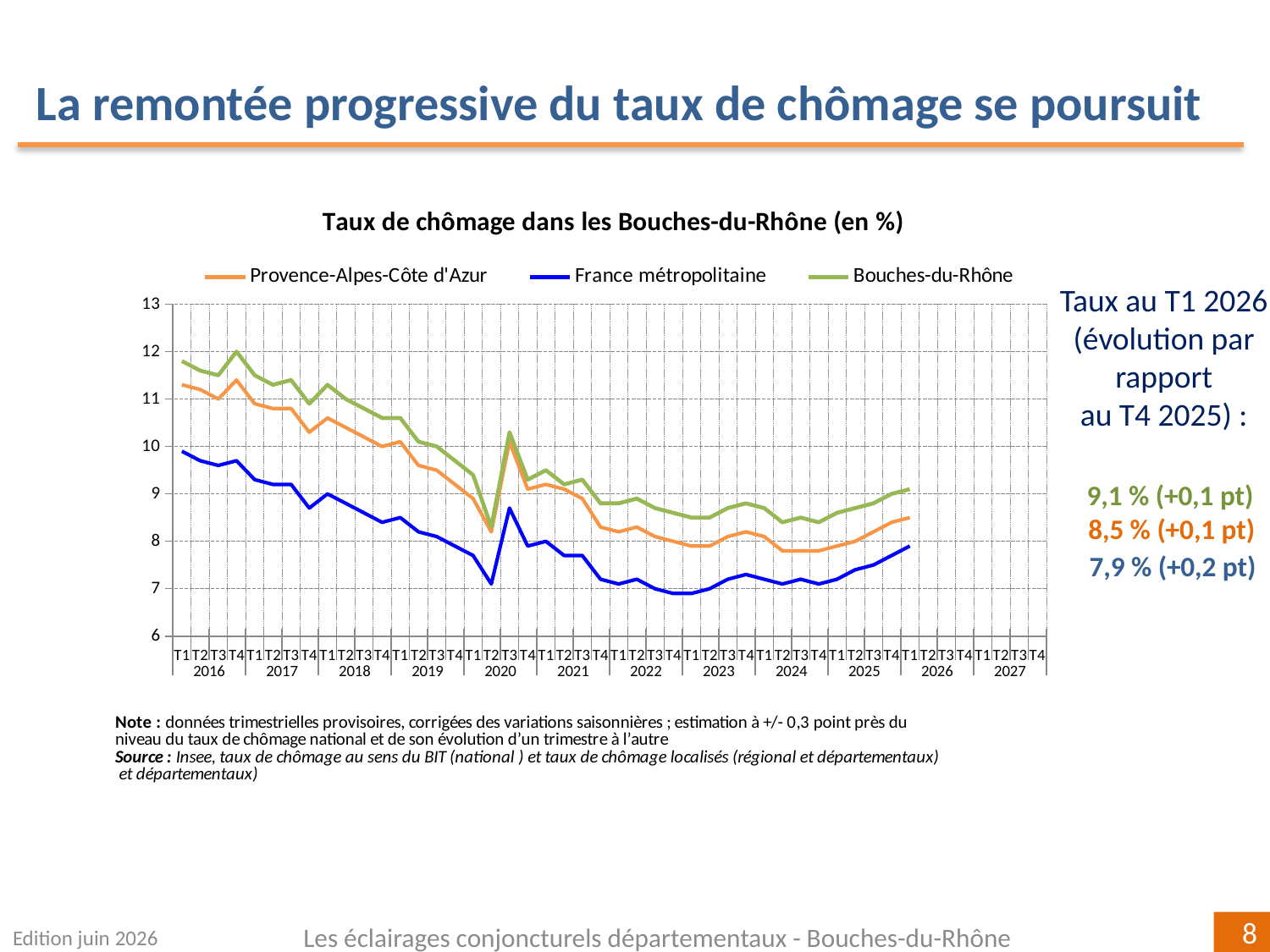
Is the value for Bouches-du-Rhône at T4 2016 greater or less than 11? greater At T1 2026, which is higher: the rate for Provence-Alpes-Côte d'Azur or for France métropolitaine? Provence-Alpes-Côte d'Azur What is the unemployment rate for Bouches-du-Rhône at T1 2026? 9,1 % What is the unemployment rate for Provence-Alpes-Côte d'Azur at T1 2026? 8,5 % Which series has the lowest value at T1 2026? France métropolitaine How many series does the legend of the chart list? 3 What is the title of the chart? Taux de chômage dans les Bouches-du-Rhône (en %) Is the value for France métropolitaine at T1 2016 greater or less than 9? greater What is the unemployment rate for France métropolitaine at T1 2026? 7,9 % Between T1 2016 and T4 2019, does the Bouches-du-Rhône series rise or fall overall? Fall What kind of chart is shown on the slide? Line chart At T1 2026, what is the difference between the Bouches-du-Rhône rate and the France métropolitaine rate? 1,2 points